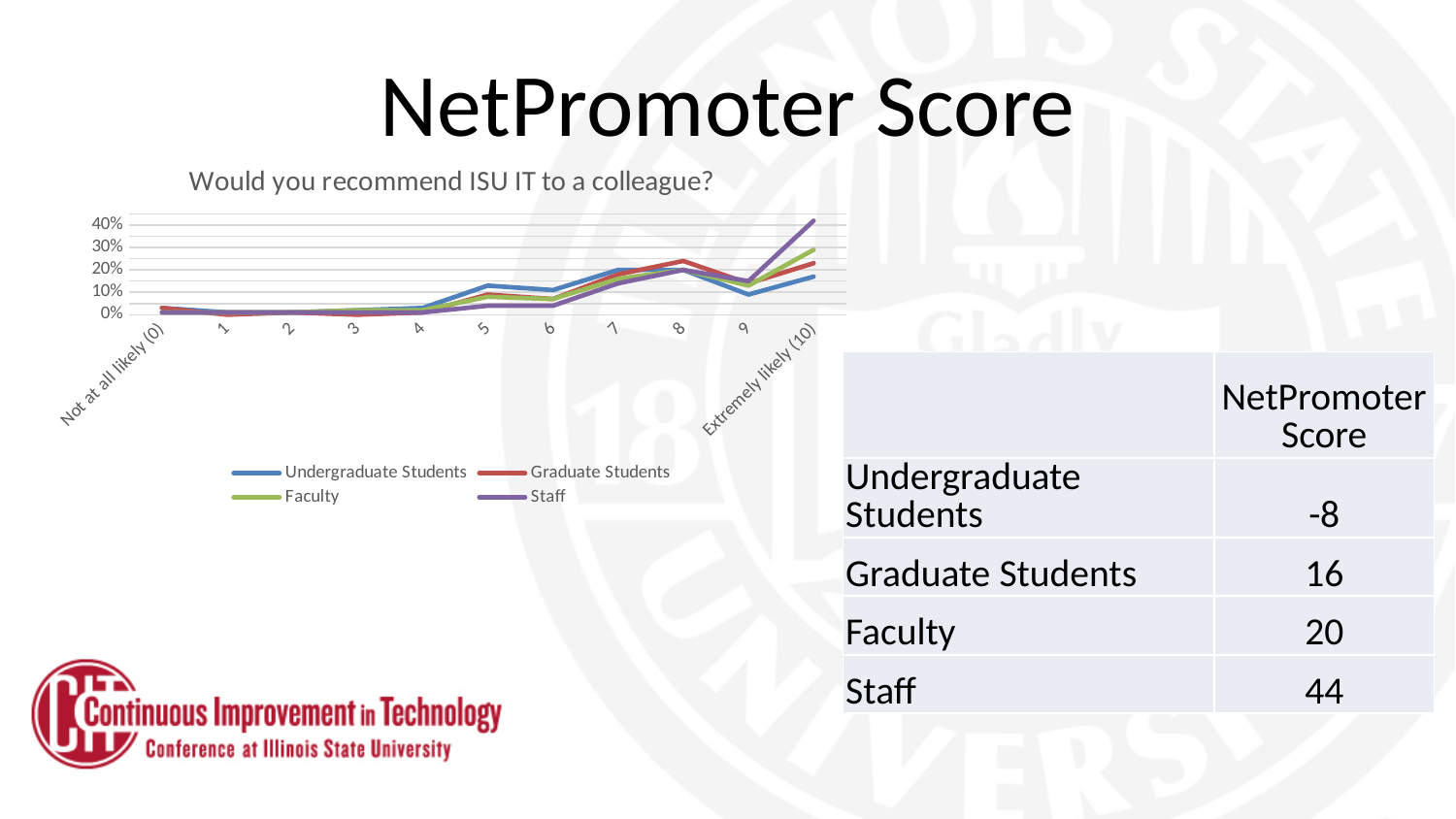
Do the values for Staff generally rise or fall from Not at all likely (0) to Extremely likely (10)? rise Which series is drawn in purple in the chart? Staff Which series has the highest value at Extremely likely (10)? Staff Is the value for Staff at category 5 greater or less than 10%? less Is the value for Undergraduate Students at Extremely likely (10) greater or less than 20%? less What kind of chart is shown on the slide? line chart At Extremely likely (10), which is larger: the value for Staff or the value for Undergraduate Students? Staff Is the value for Staff at Extremely likely (10) greater or less than 30%? greater How many series does the chart's legend list? 4 What is the title of the chart? Would you recommend ISU IT to a colleague? How many categories are shown along the x axis of the chart? 11 Which series has the lowest value at Extremely likely (10)? Undergraduate Students